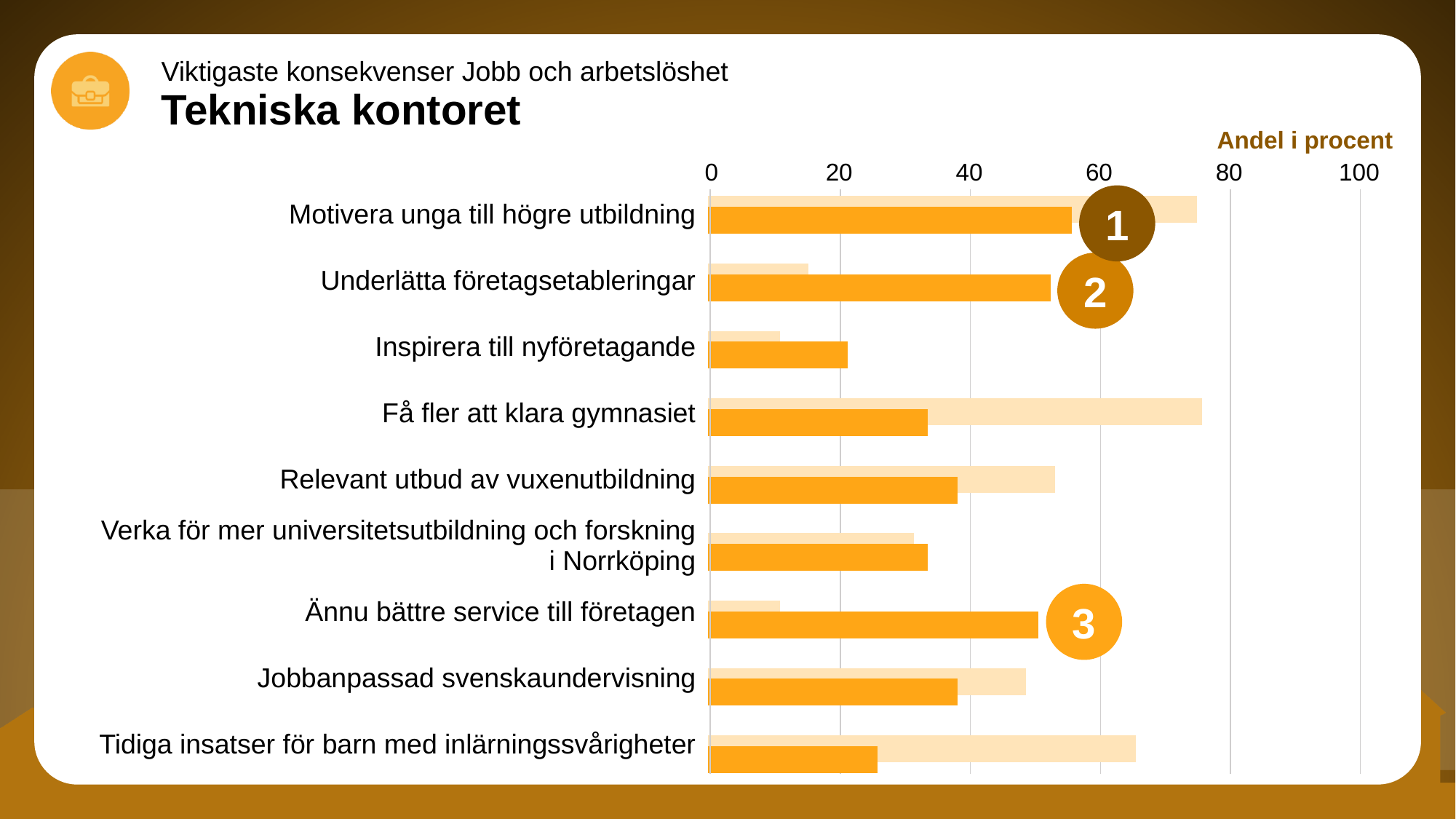
What is the title of the chart's value axis? Andel i procent Is the light orange bar for Underlätta företagsetableringar greater or less than 20? less Which category has the shortest dark orange bar? Inspirera till nyföretagande Which category is marked with the circled number 3? Ännu bättre service till företagen What kind of chart is shown on the slide? bar chart Is the dark orange bar for Inspirera till nyföretagande greater or less than 40? less For Få fler att klara gymnasiet, which bar is longer, the light orange or the dark orange one? light orange Is the light orange bar for Få fler att klara gymnasiet greater or less than 60? greater Which has the longer dark orange bar, Motivera unga till högre utbildning or Inspirera till nyföretagande? Motivera unga till högre utbildning How many categories are listed on the chart? 9